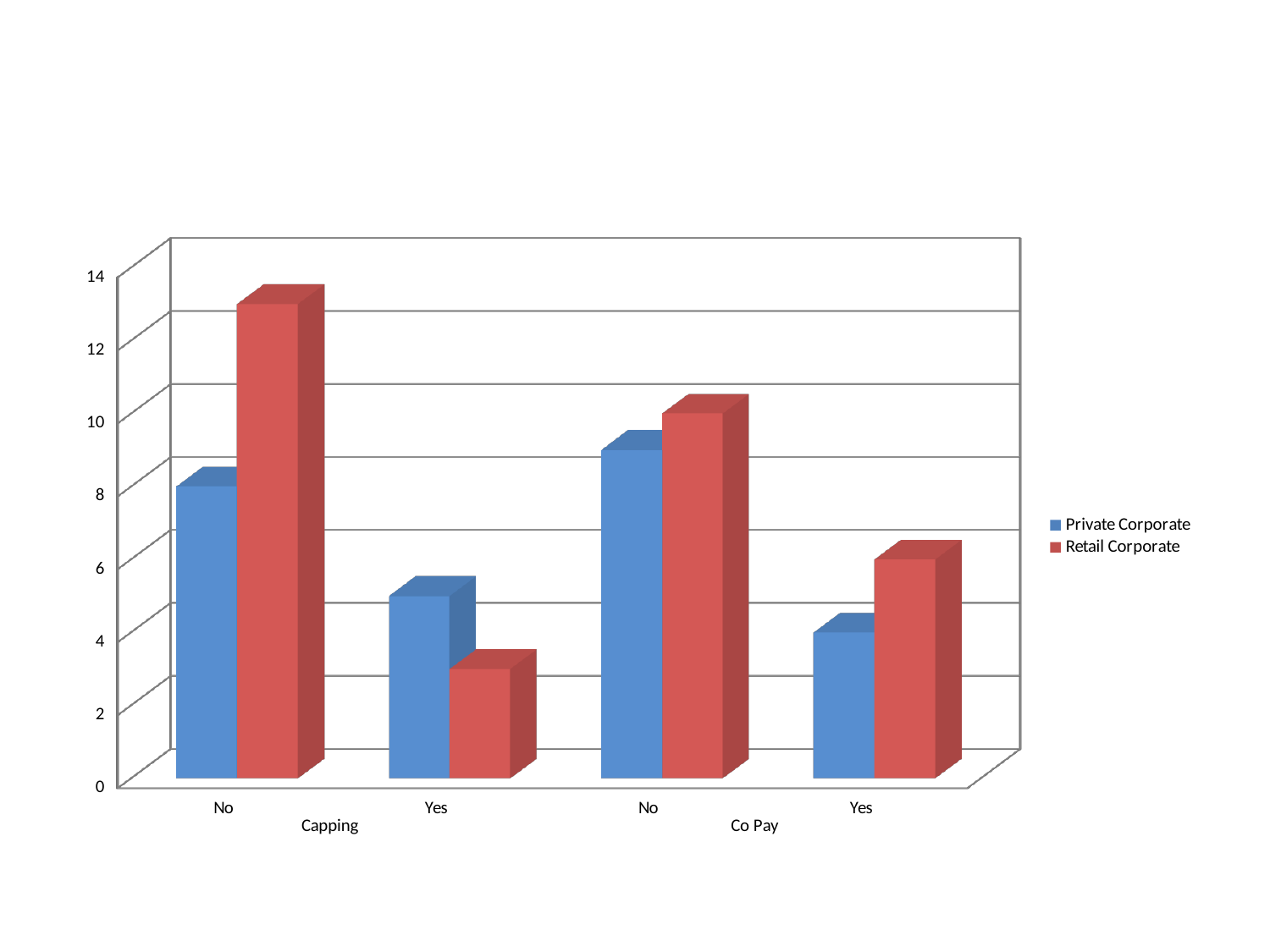
Which series is shown in blue in the legend? Private Corporate Is the Private Corporate value for Capping No greater or less than 6? greater How many series does the legend list? 2 How many category groups are shown along the x axis? 4 Is the Retail Corporate value for Capping Yes greater or less than 4? less What kind of chart is shown on the slide? bar chart For Capping No, which series has the larger value, Private Corporate or Retail Corporate? Retail Corporate Is the Retail Corporate value for Capping No greater or less than 12? greater For which category is the Retail Corporate bar the highest? Capping No For Capping Yes, which series has the larger value, Private Corporate or Retail Corporate? Private Corporate Which series is shown in red in the legend? Retail Corporate